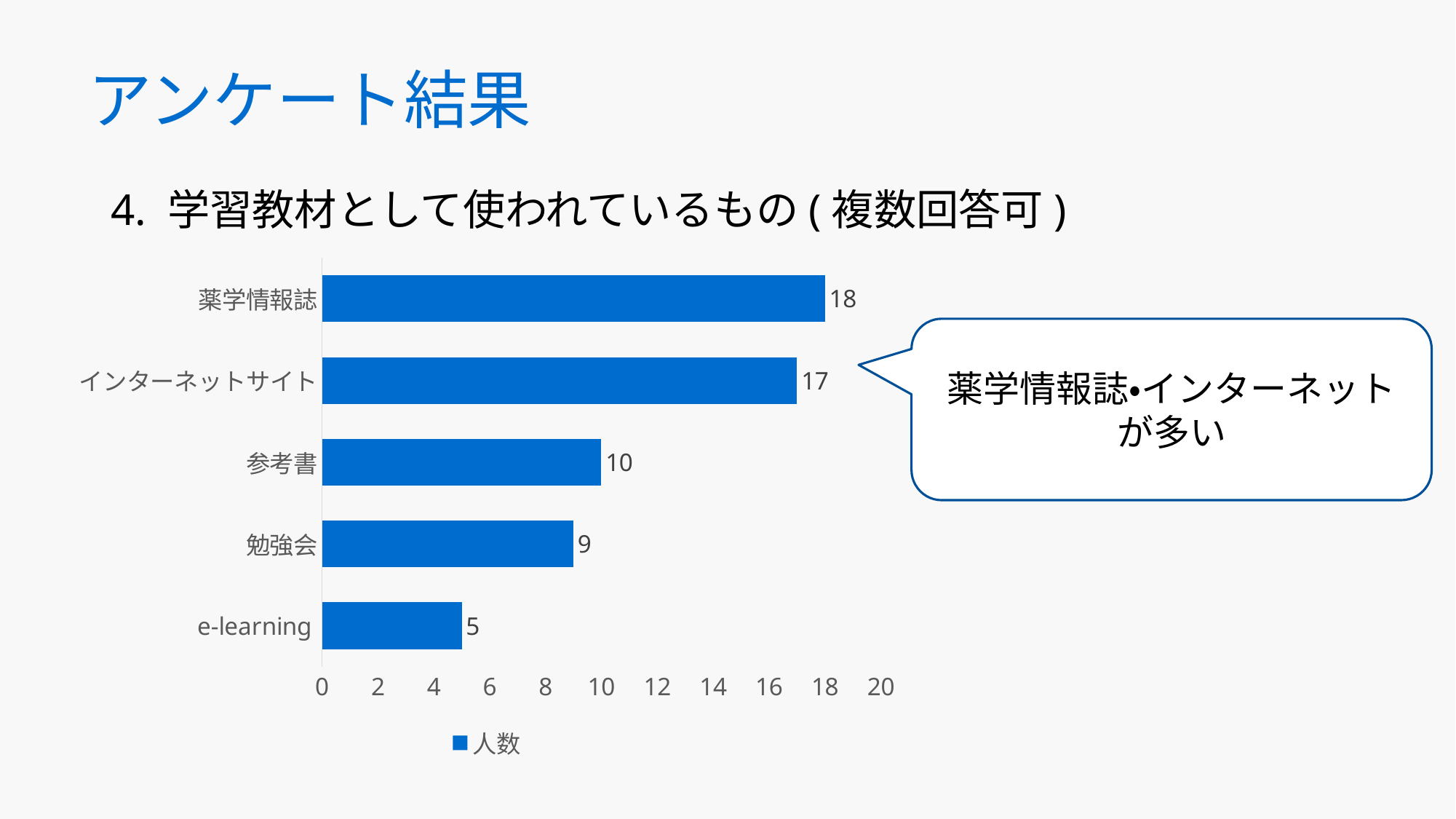
Which category has the highest value? 薬学情報誌 What is the value for e-learning? 5 Which category has the lowest value? e-learning What is the value for 参考書? 10 What kind of chart is shown on the slide? bar chart What is the value for 薬学情報誌? 18 What is the difference between the values for 参考書 and e-learning? 5 What series name does the legend show? 人数 What is the difference between the values for 薬学情報誌 and 勉強会? 9 What is the value for インターネットサイト? 17 Which is larger, the value for 参考書 or the value for 勉強会? 参考書 How many categories are shown in the chart? 5